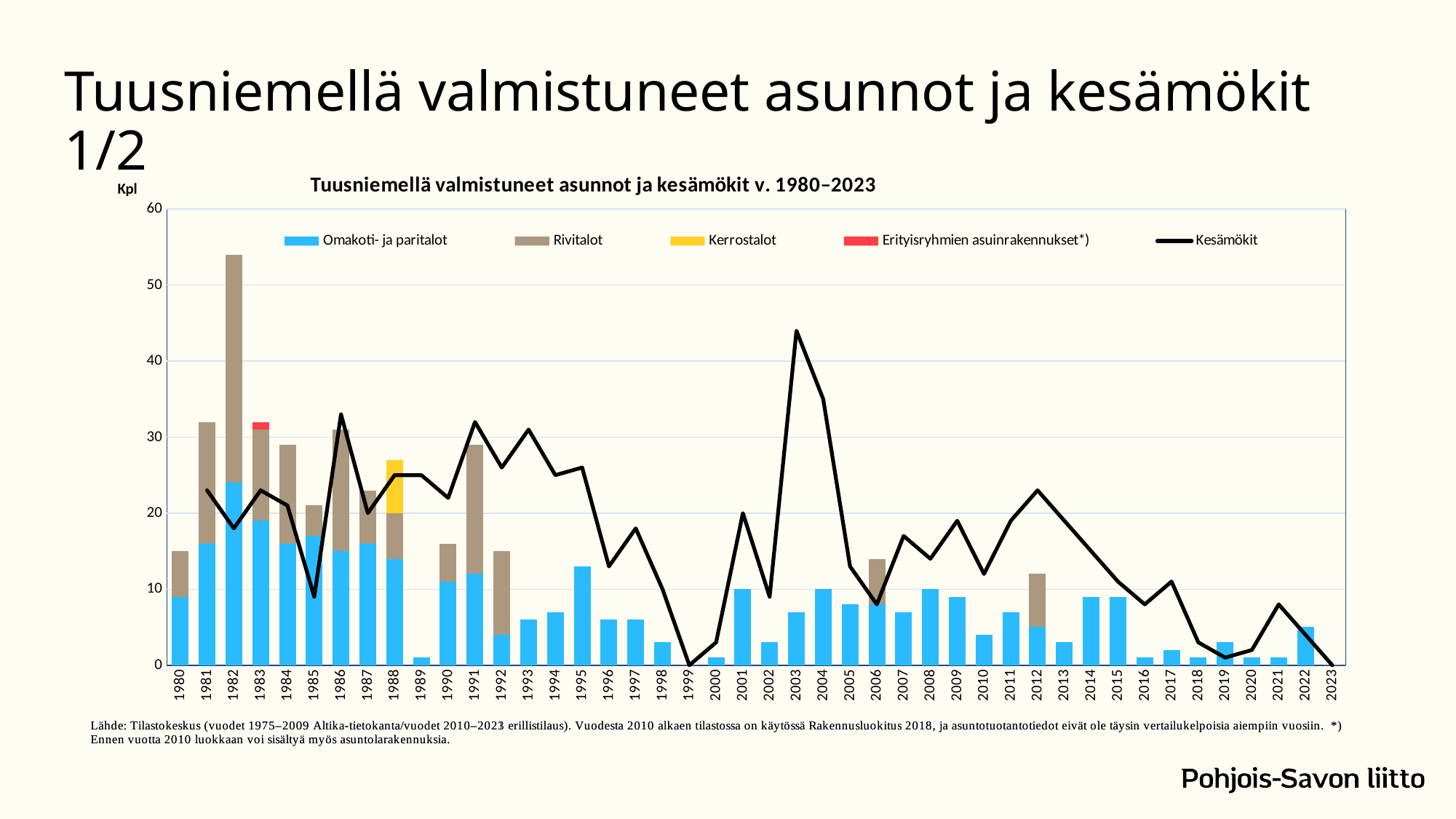
Is the Kesämökit value for 1996 greater or less than 20? less Is the Kesämökit value for 2003 greater or less than 40? greater Is the total stacked bar for 1988 greater or less than 20? greater What unit label is shown above the y axis? Kpl In which year does the Kesämökit line reach its highest value? 2003 What kind of chart is shown on the slide? bar chart with a line How many series does the legend list? 5 Does the Kesämökit line generally rise or fall from 2012 to 2019? fall Which year has the larger Kesämökit value, 2003 or 2004? 2003 In which year is the total stacked bar the highest? 1982 How many years are shown on the x axis? 44